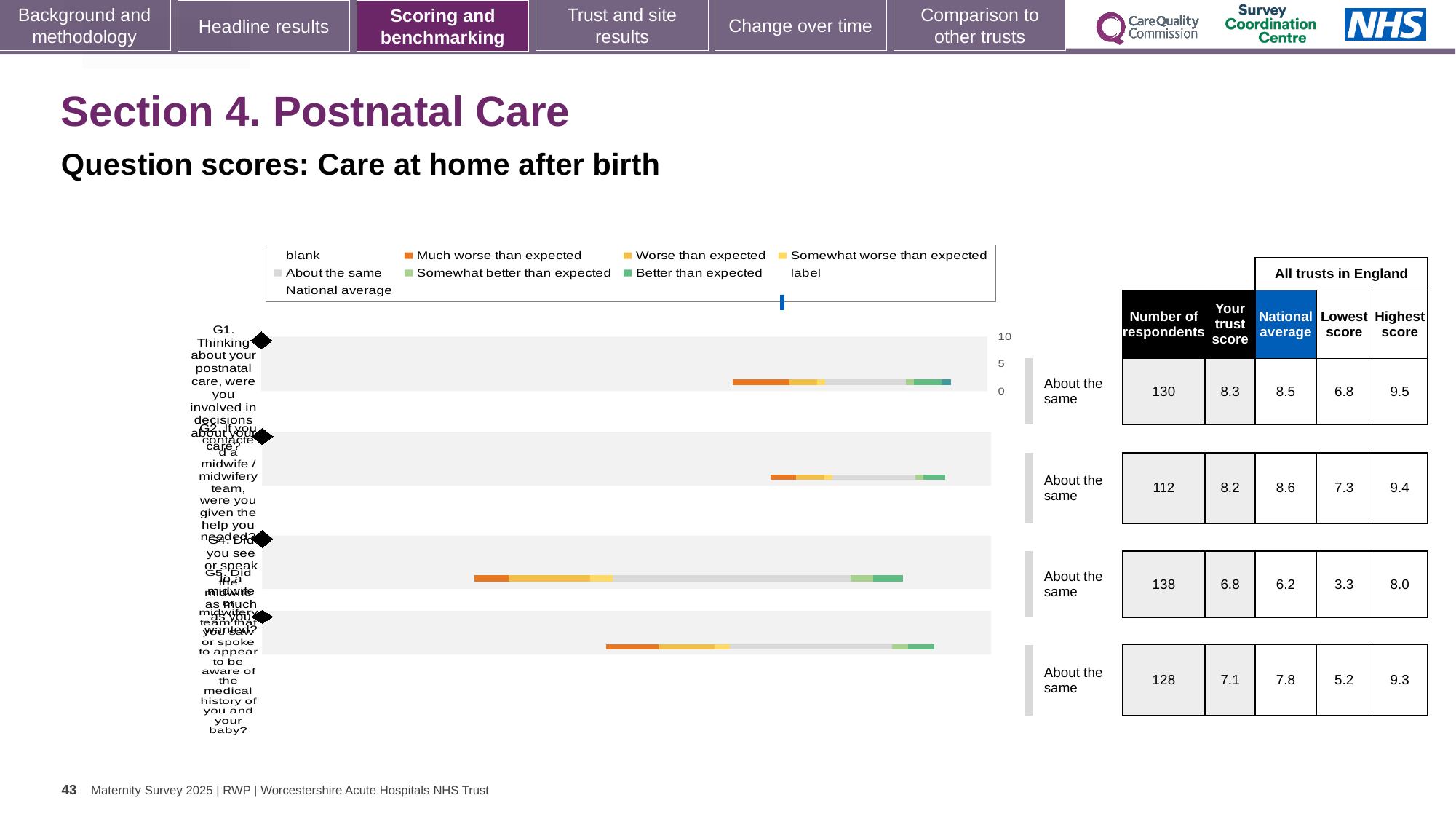
According to the table beside the chart, what is the highest score in England for the third row question? 8.0 What is the difference between the national average and the trust score for the fourth row (7.8 vs 7.1)? 0.7 According to the table beside the chart, what is the lowest score in England for the fourth row question? 5.2 How many question rows (bars) are plotted in the chart? 4 According to the table beside the chart, what is the trust score for the first row (G1, involved in decisions about your postnatal care)? 8.3 What benchmark label is shown to the right of each bar in the chart? About the same What kind of chart is shown on the slide? bar chart According to the table beside the chart, what is the national average for the first row (G1)? 8.5 According to the table beside the chart, how many respondents answered the second row question (G2)? 112 Which row has the highest number of respondents in the table beside the chart? the third row (138) Is the trust score for the third row (6.8) larger or smaller than its national average (6.2)? larger Which row has the lowest trust score in the table beside the chart? the third row (6.8)